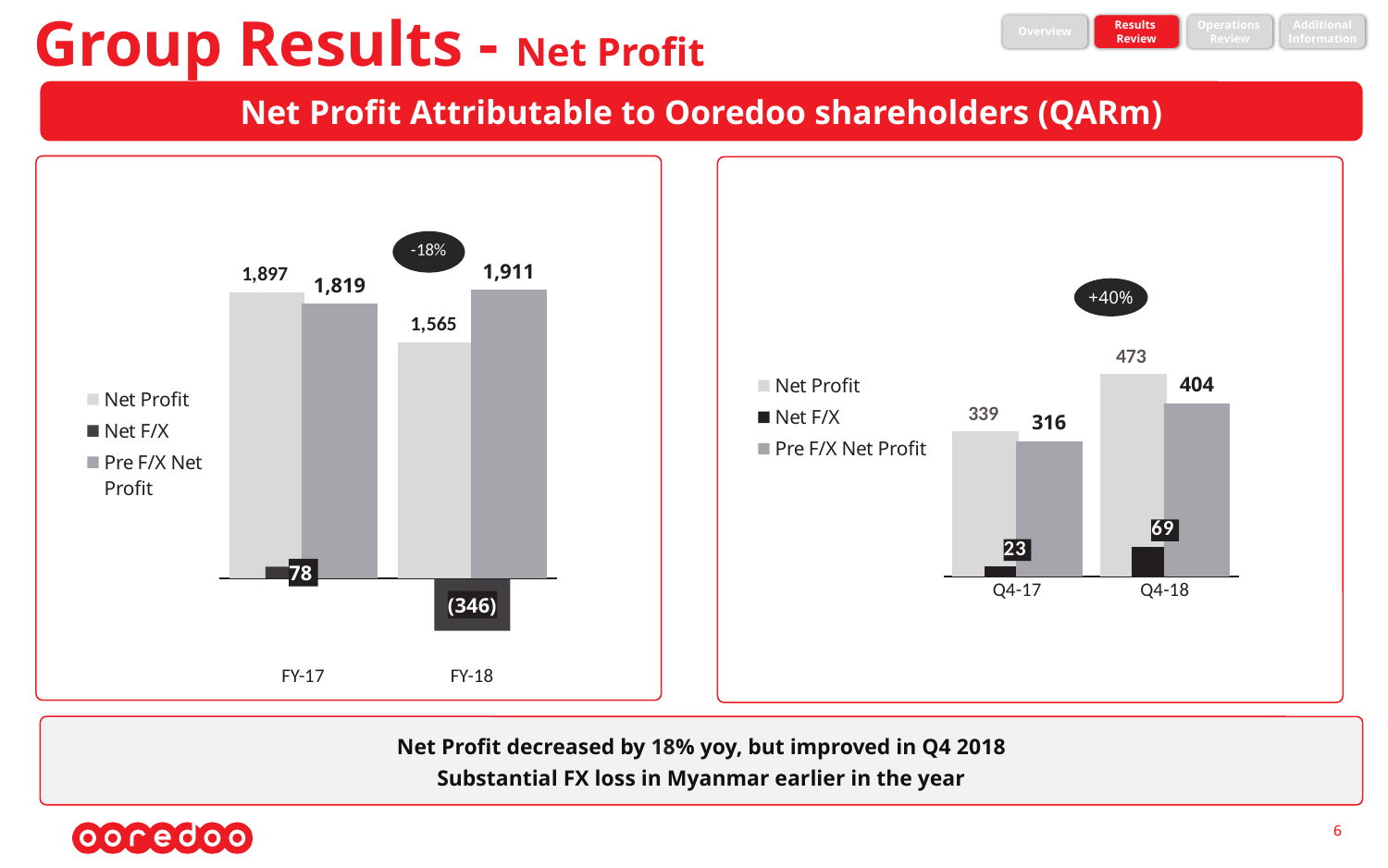
In the right chart (Q4-17 vs Q4-18), what is the Net Profit value for Q4-18? 473 In the right chart (Q4-17 vs Q4-18), what is the Net F/X value for Q4-17? 23 In the left chart (FY-17 vs FY-18), what is the Net F/X value for FY-18? (346) What type of chart is the left chart (FY-17 vs FY-18)? Bar chart In the left chart (FY-17 vs FY-18), what is the difference between Net Profit in FY-17 and FY-18? 332 In the right chart (Q4-17 vs Q4-18), what is the difference between Pre F/X Net Profit in Q4-18 and Q4-17? 88 What percentage change is shown in the oval label on the right chart (Q4-17 vs Q4-18)? +40% In the left chart (FY-17 vs FY-18), what is the Net Profit value for FY-17? 1,897 In the right chart (Q4-17 vs Q4-18), which quarter has the lower Net Profit? Q4-17 In the left chart (FY-17 vs FY-18), which year has the higher Pre F/X Net Profit? FY-18 How many series does the legend of the right chart (Q4-17 vs Q4-18) list? 3 In the left chart (FY-17 vs FY-18), what is the Pre F/X Net Profit value for FY-18? 1,911